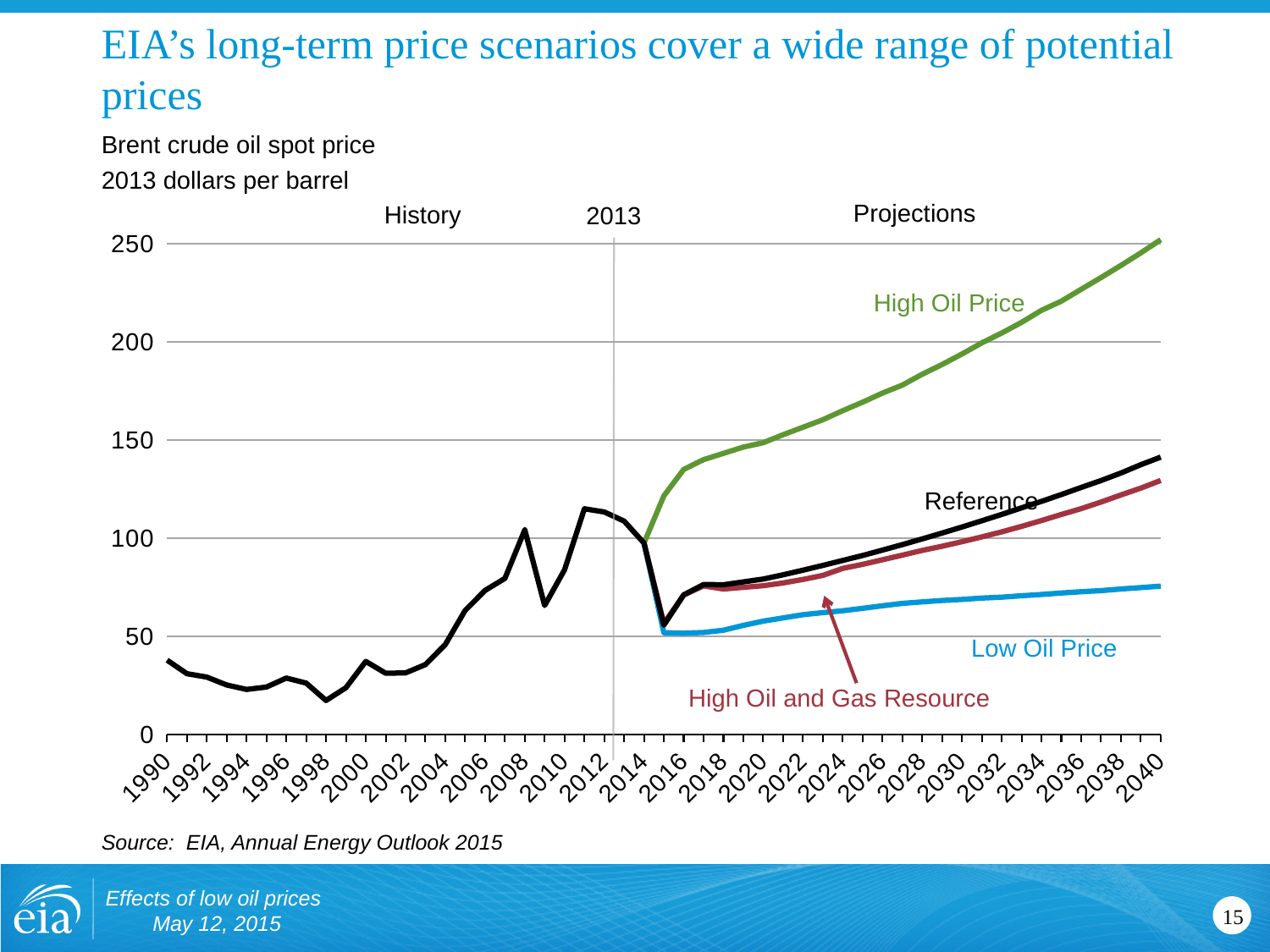
What kind of chart is shown on the slide? line chart Which year marks the boundary between History and Projections on the chart? 2013 Does the High Oil Price scenario rise or fall between 2016 and 2040? rise In 2040, which is higher: the Reference scenario or the High Oil and Gas Resource scenario? Reference Which scenario has the lowest Brent crude oil spot price in 2040? Low Oil Price Is the Reference scenario value in 2040 greater or less than 150? less In what units is the Brent crude oil spot price expressed on the chart? 2013 dollars per barrel Is the historical Brent crude oil spot price in 1998 greater or less than 50? less Is the High Oil Price scenario value in 2030 greater or less than 150? greater How many projection scenarios are plotted on the chart? 4 Which scenario has the highest Brent crude oil spot price in 2040? High Oil Price